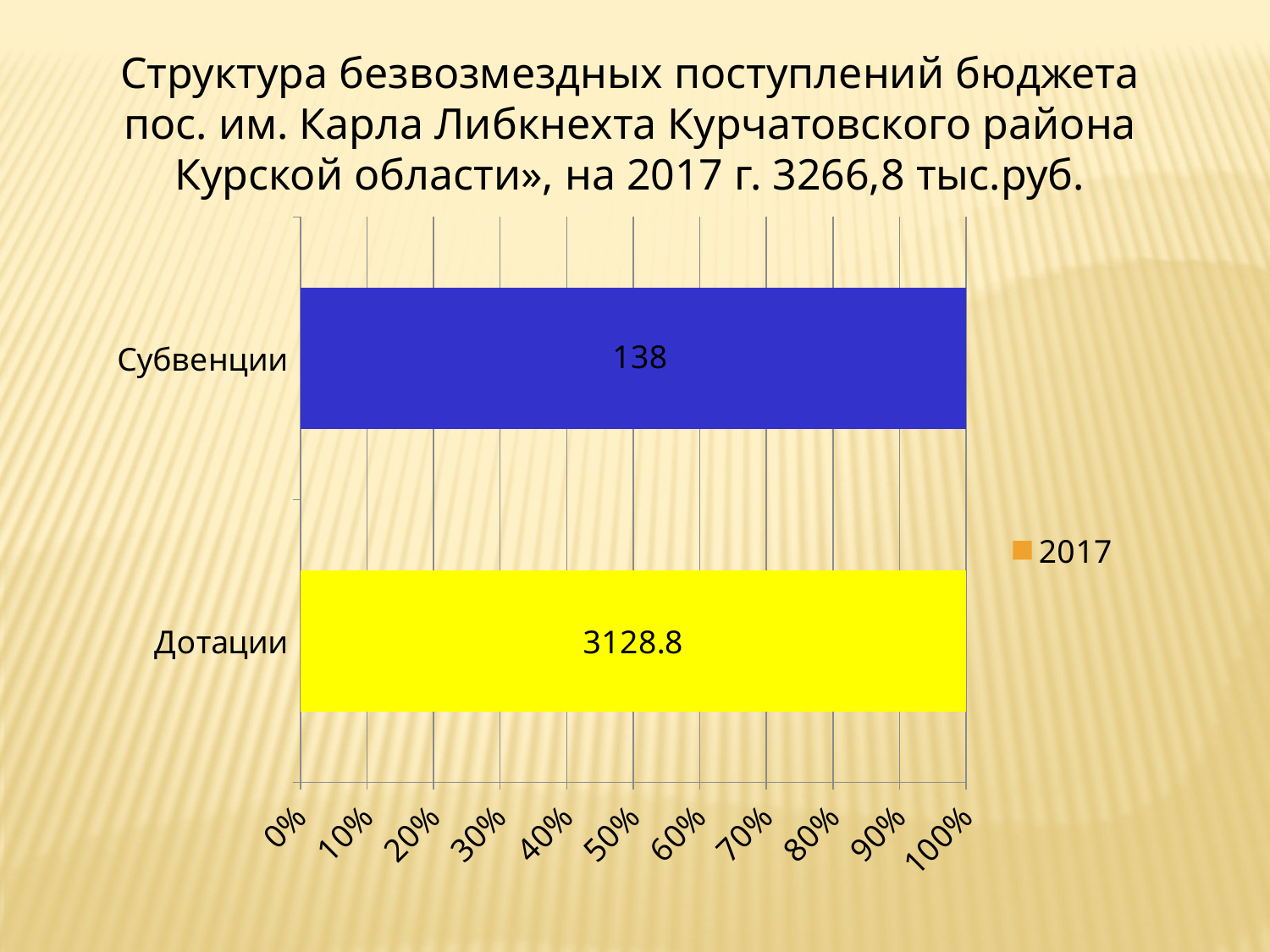
Which category has the smaller data label value? Субвенции How many categories are shown on the chart? 2 What colour is the bar for Дотации? yellow What kind of chart is shown on the slide? bar chart What entry is shown in the chart legend? 2017 What is the difference between the data labels for Дотации and Субвенции? 2990.8 What is the data label on the bar for Дотации? 3128.8 Which category has the larger data label value? Дотации What is the data label on the bar for Субвенции? 138 How many series does the legend list? 1 Is the data label for Субвенции larger or smaller than the data label for Дотации? smaller What is the sum of the two data labels shown on the chart? 3266.8